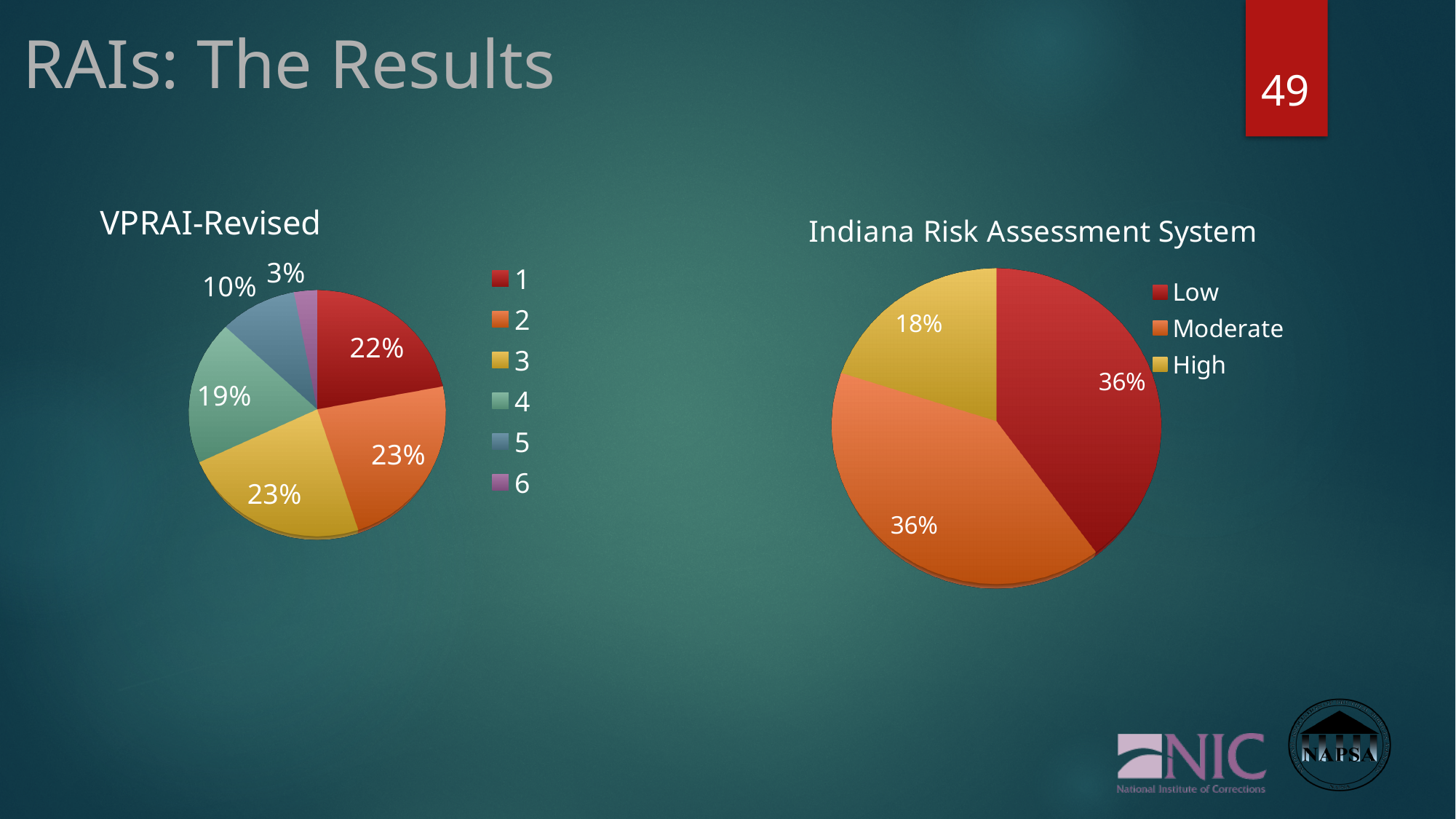
In the VPRAI-Revised chart, what share of the pie does category 4 have? 19% In the VPRAI-Revised chart, which category has the smallest slice? 6 In the Indiana Risk Assessment System chart, what share of the pie is Moderate? 36% In the VPRAI-Revised chart, how many categories does the legend list? 6 In the Indiana Risk Assessment System chart, how many entries does the legend list? 3 In the VPRAI-Revised chart, what is the difference between the shares of category 4 and category 5? 9% In the VPRAI-Revised chart, which is larger, the slice for category 1 or the slice for category 5? 1 In the Indiana Risk Assessment System chart, what share of the pie is High? 18% In the Indiana Risk Assessment System chart, what is the difference between the Low and High shares? 18% In the VPRAI-Revised chart, what share of the pie does category 1 have? 22% In the Indiana Risk Assessment System chart, which category has the smallest slice? High What kind of chart is the Indiana Risk Assessment System chart? Pie chart